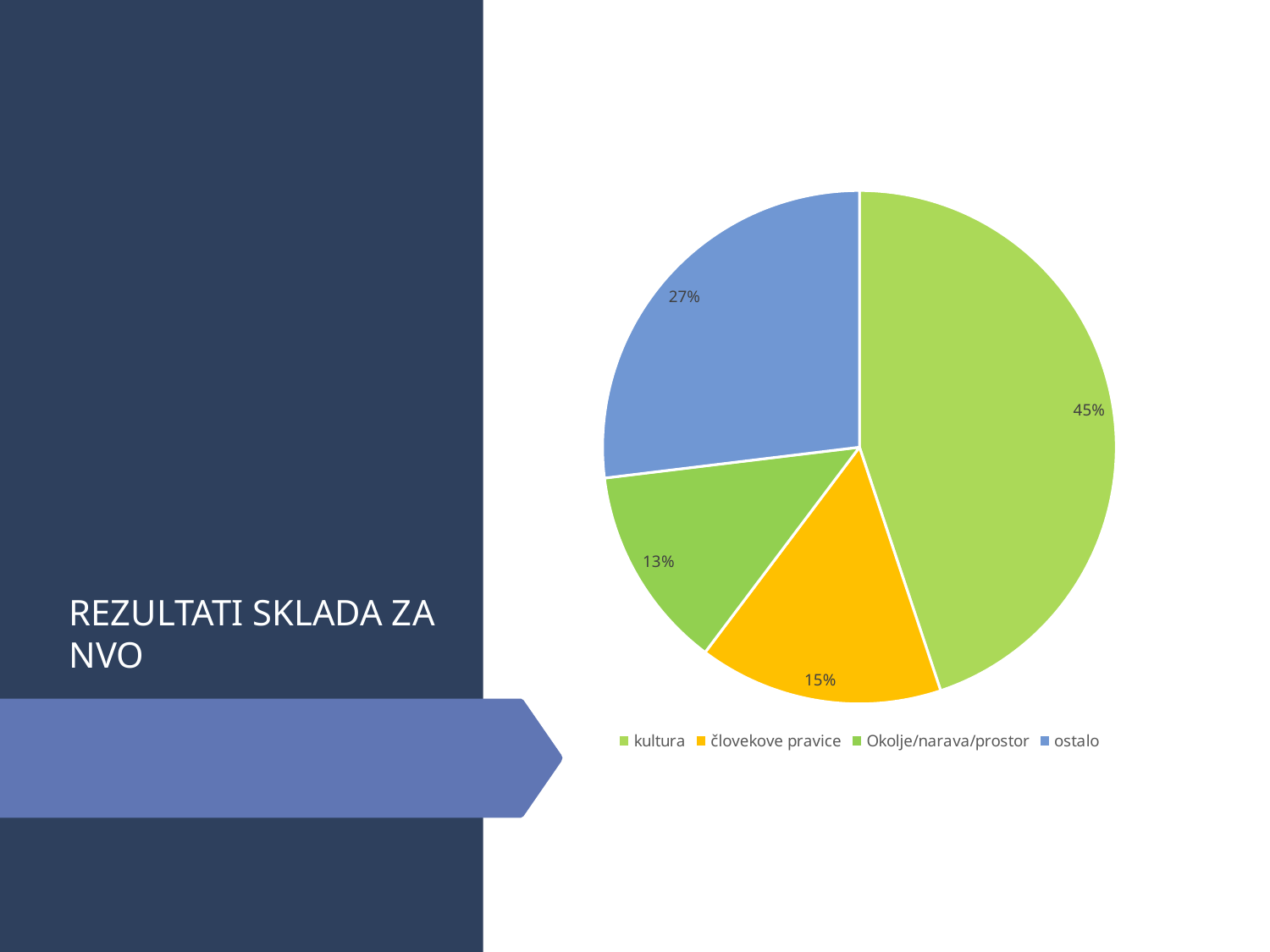
What kind of chart is shown on the slide? pie chart Which category has the smallest slice of the pie? Okolje/narava/prostor What share of the pie does človekove pravice have? 15% What share of the pie does Okolje/narava/prostor have? 13% Which category has the largest slice of the pie? kultura Which is larger, the slice for človekove pravice or the slice for ostalo? ostalo What share of the pie does ostalo have? 27% How many slices does the pie chart have? 4 What is the difference in percentage points between kultura and ostalo? 18 What share of the pie does kultura have? 45% What is the combined share of kultura and človekove pravice? 60% What colour is the slice for človekove pravice? yellow